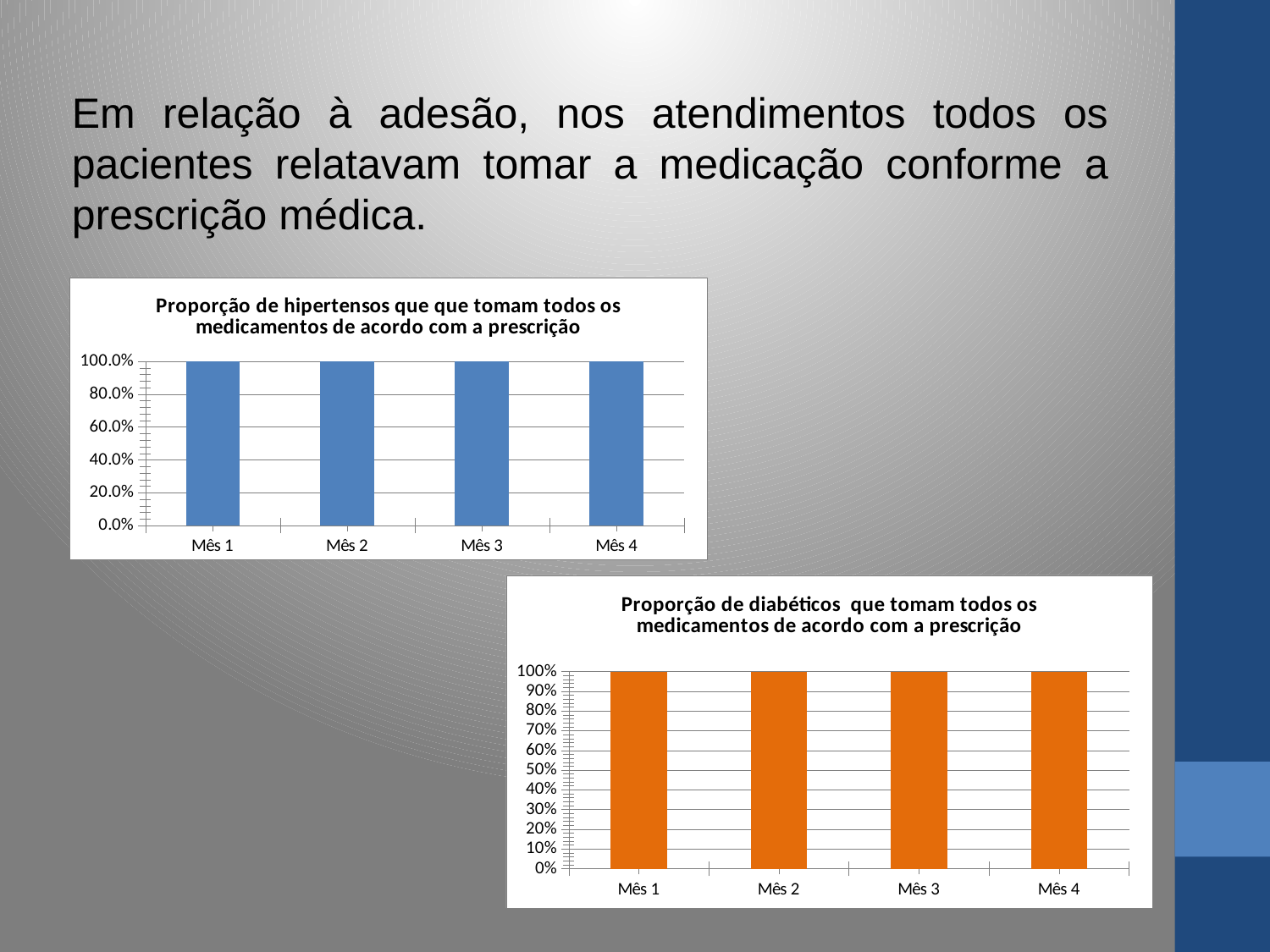
In the chart titled 'Proporção de hipertensos que que tomam todos os medicamentos de acordo com a prescrição', what is the value for Mês 4? 100.0% In the chart titled 'Proporção de hipertensos que que tomam todos os medicamentos de acordo com a prescrição', is the value for Mês 2 greater or less than 80.0%? greater In the chart titled 'Proporção de diabéticos que tomam todos os medicamentos de acordo com a prescrição', what is the difference between the values for Mês 1 and Mês 4? 0% In the lower-right chart about diabéticos, how many bars are plotted? 4 In the chart titled 'Proporção de diabéticos que tomam todos os medicamentos de acordo com a prescrição', what is the value for Mês 2? 100% In the chart titled 'Proporção de hipertensos que que tomam todos os medicamentos de acordo com a prescrição', what is the value for Mês 1? 100.0% In the chart titled 'Proporção de hipertensos que que tomam todos os medicamentos de acordo com a prescrição', do the values rise, fall, or stay the same from Mês 1 to Mês 4? stay the same In the chart titled 'Proporção de diabéticos que tomam todos os medicamentos de acordo com a prescrição', what is the value for Mês 3? 100% What colour are the bars in the chart titled 'Proporção de diabéticos que tomam todos os medicamentos de acordo com a prescrição'? orange What kind of chart is the chart titled 'Proporção de diabéticos que tomam todos os medicamentos de acordo com a prescrição'? bar chart In the upper-left chart about hipertensos, how many categories are shown on the x axis? 4 In the chart titled 'Proporção de diabéticos que tomam todos os medicamentos de acordo com a prescrição', is the value for Mês 4 greater or less than 50%? greater